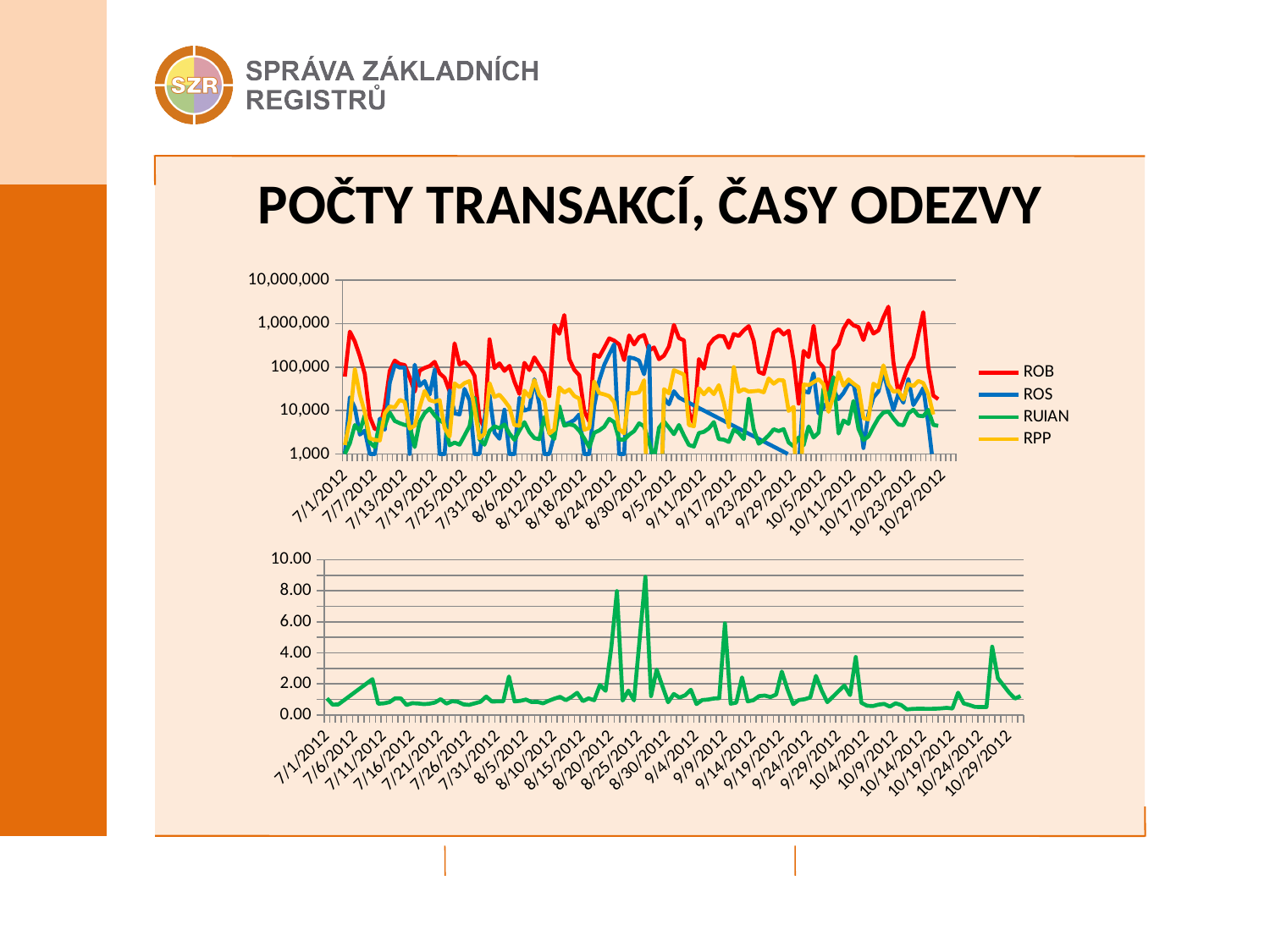
What kind of chart is the bottom chart on the slide? line chart In the bottom chart, is the peak around 8/20/2012 greater or less than 6.00? greater In the bottom chart, is the peak around 10/24/2012 greater or less than 2.00? greater In the top chart, which series reaches the highest values overall? ROB What are the series names listed in the legend of the top chart? ROB, ROS, RUIAN, RPP What is the highest value shown on the y axis of the top chart? 10,000,000 In the top chart, is the peak value of ROB around 10/17/2012 greater or less than 1,000,000? greater What kind of chart is the top chart on the slide? line chart In the top chart, which series is larger around 10/17/2012, ROB or RUIAN? ROB How many series does the legend of the top chart list? 4